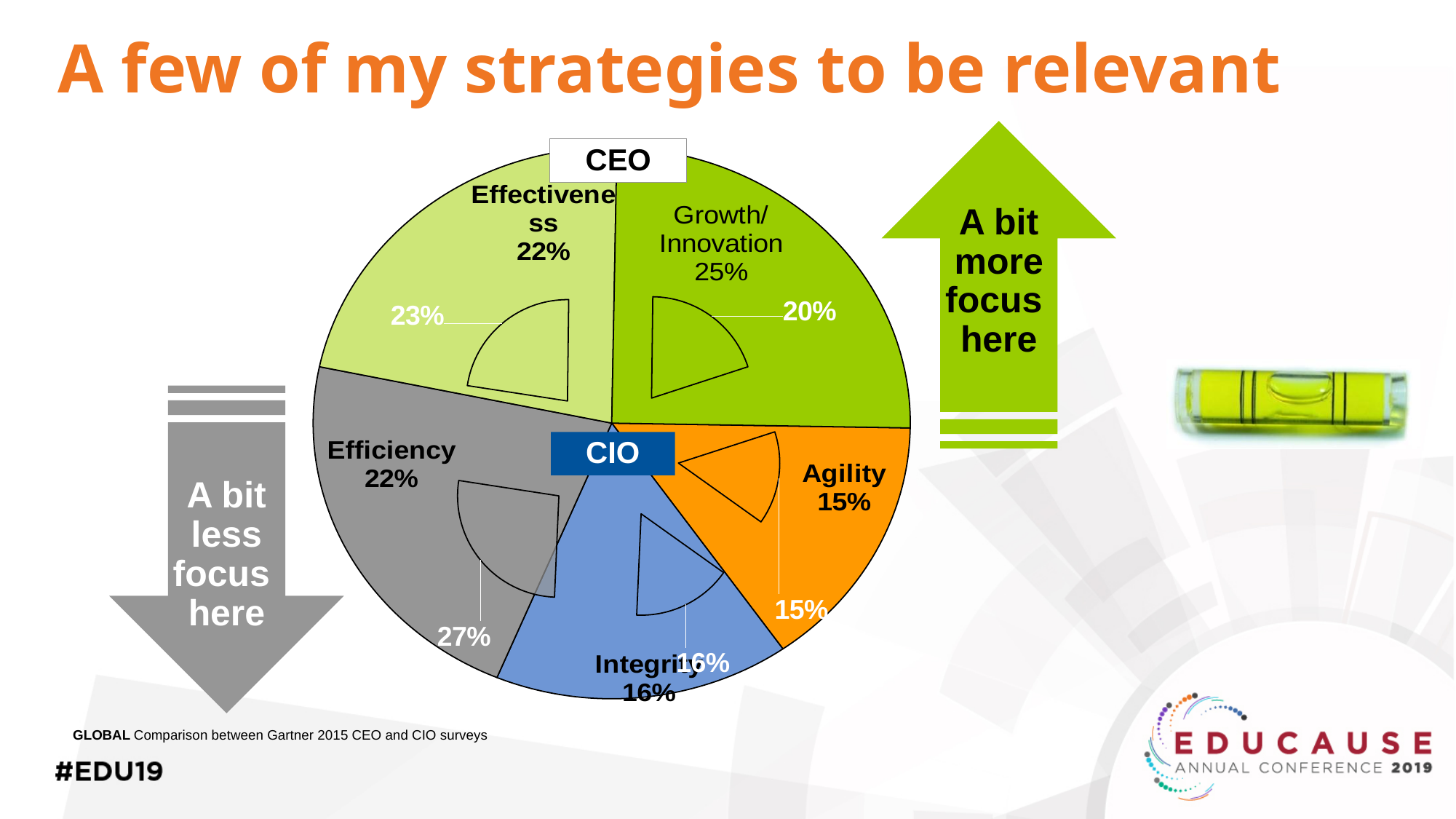
Which slice has the lowest percentage printed with its label? Agility What is the difference between the Growth/Innovation percentage (25%) and the Agility percentage (15%)? 10 percentage points How many labelled slices does the pie chart have? 5 Which slice has the highest percentage printed with its label? Growth/Innovation According to the note below the chart, which two surveys are being compared? Gartner 2015 CEO and CIO surveys Which slice has the larger labelled percentage, Efficiency or Integrity? Efficiency What percentage is printed with the Integrity slice label? 16% What kind of chart is shown on the slide? pie chart What percentage is printed on the smaller inner wedge inside the Efficiency slice? 27% What percentage is printed with the Growth/Innovation slice label? 25% What percentage is printed with the Efficiency slice label? 22% What percentage is printed with the Agility slice label? 15%